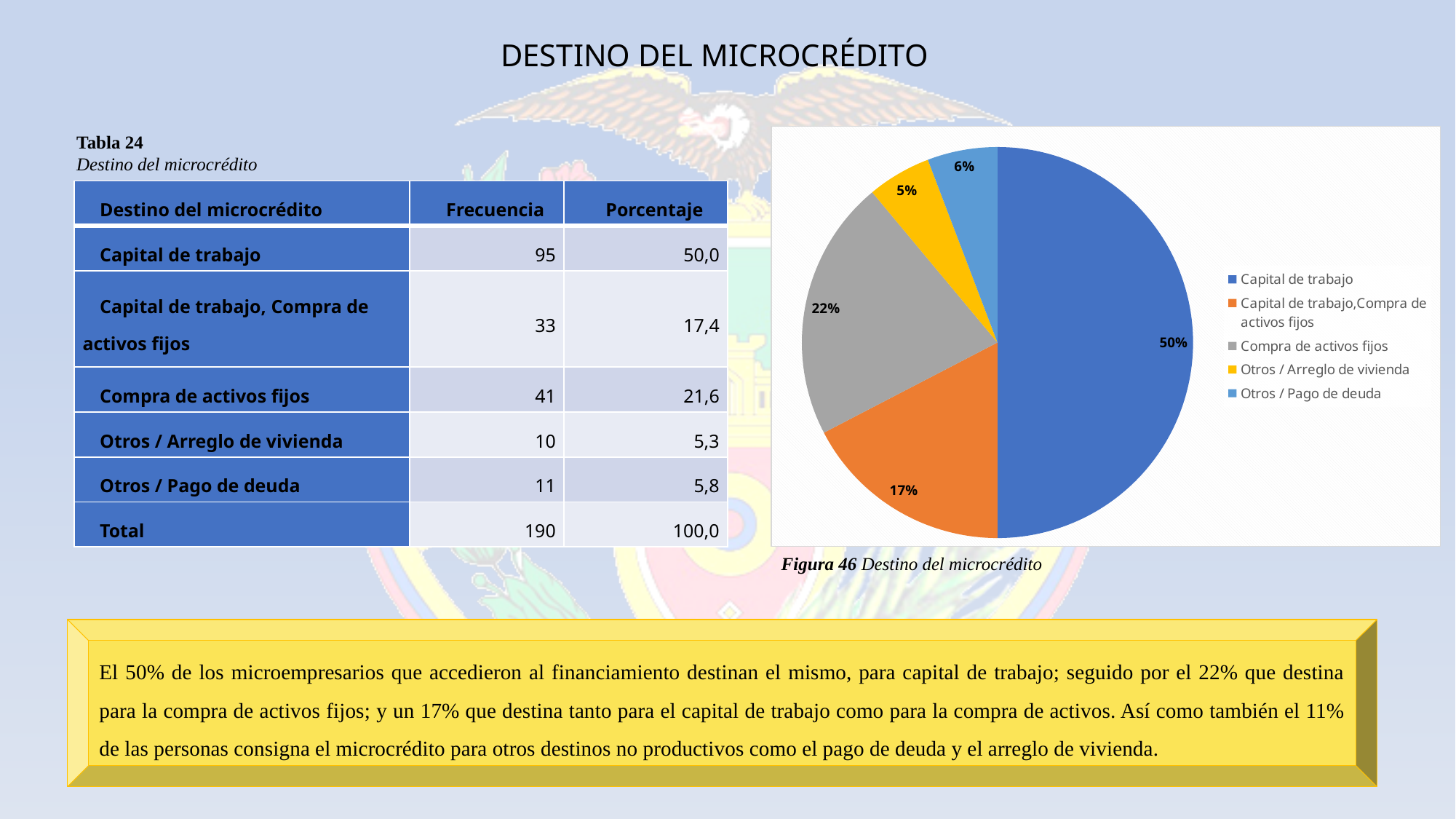
In the pie chart, what share is labelled for Capital de trabajo? 50% What is the difference in percentage points between the Capital de trabajo slice and the Compra de activos fijos slice in the pie chart? 28% In the pie chart, what share is labelled for Compra de activos fijos? 22% Which category has the smallest slice in the pie chart? Otros / Arreglo de vivienda How many entries does the legend of the pie chart list? 5 In the pie chart, what share is labelled for Otros / Arreglo de vivienda? 5% In the pie chart, which slice is larger: Compra de activos fijos or Capital de trabajo, Compra de activos fijos? Compra de activos fijos What kind of chart is shown in Figura 46? pie chart Which category has the largest slice in the pie chart? Capital de trabajo In the pie chart, what share is labelled for Otros / Pago de deuda? 6% What colour is the Capital de trabajo slice in the pie chart? blue How many slices does the pie chart have? 5